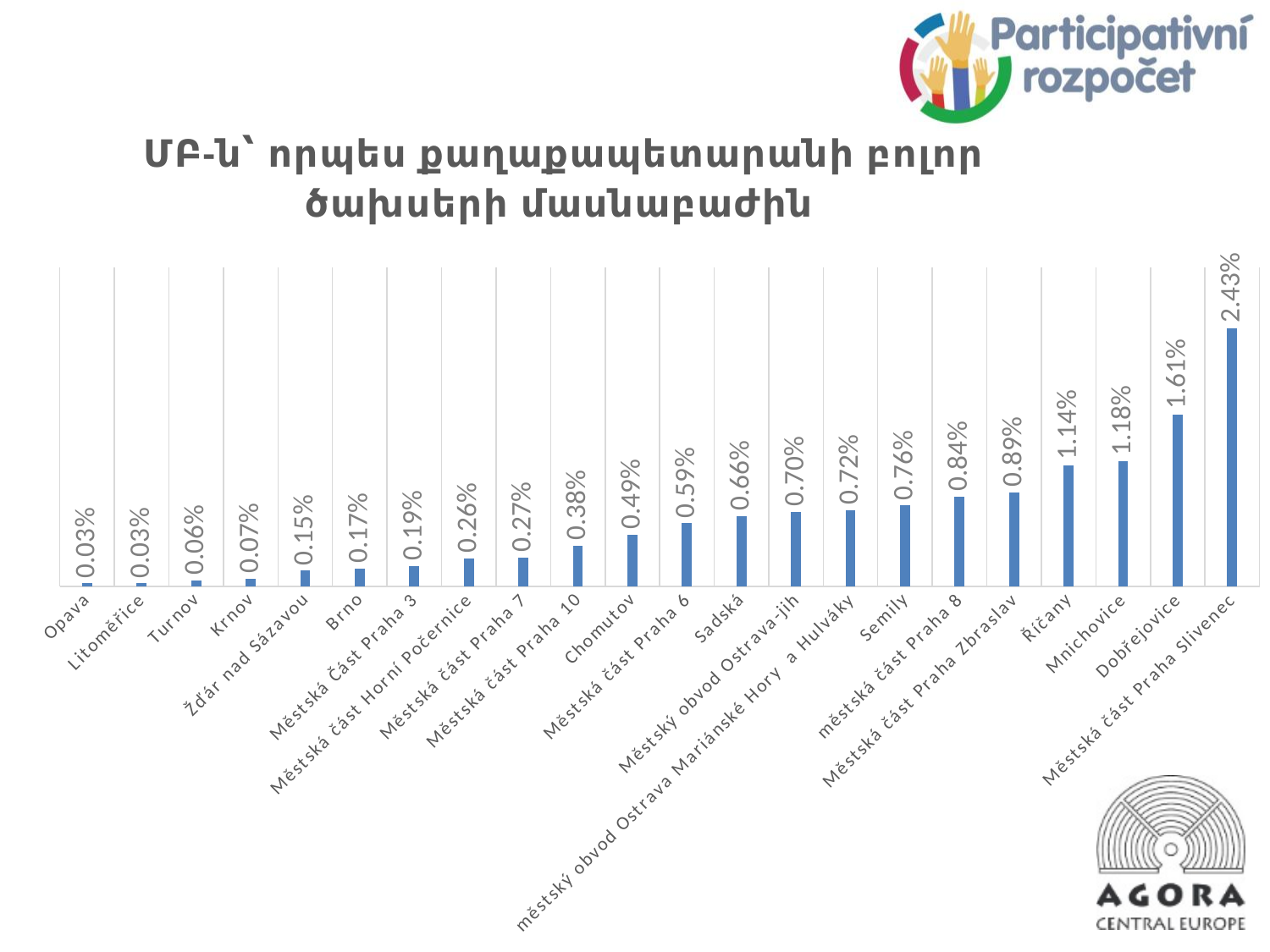
What is the value for Brno? 0.17% What is the value for Dobřejovice? 1.61% Which category has the highest value? Městská část Praha Slivenec What is the difference between the values for Mnichovice and Říčany? 0.04% What is the value for Chomutov? 0.49% What is the difference between the values for Městská část Praha Slivenec and Dobřejovice? 0.82% What is the highest value shown in the chart? 2.43% What kind of chart is shown on the slide? Bar chart How many categories are shown in the chart? 22 Do the values rise or fall from left to right along the x axis? Rise What is the value for Semily? 0.76% Which is larger, the value for Sadská or the value for Krnov? Sadská